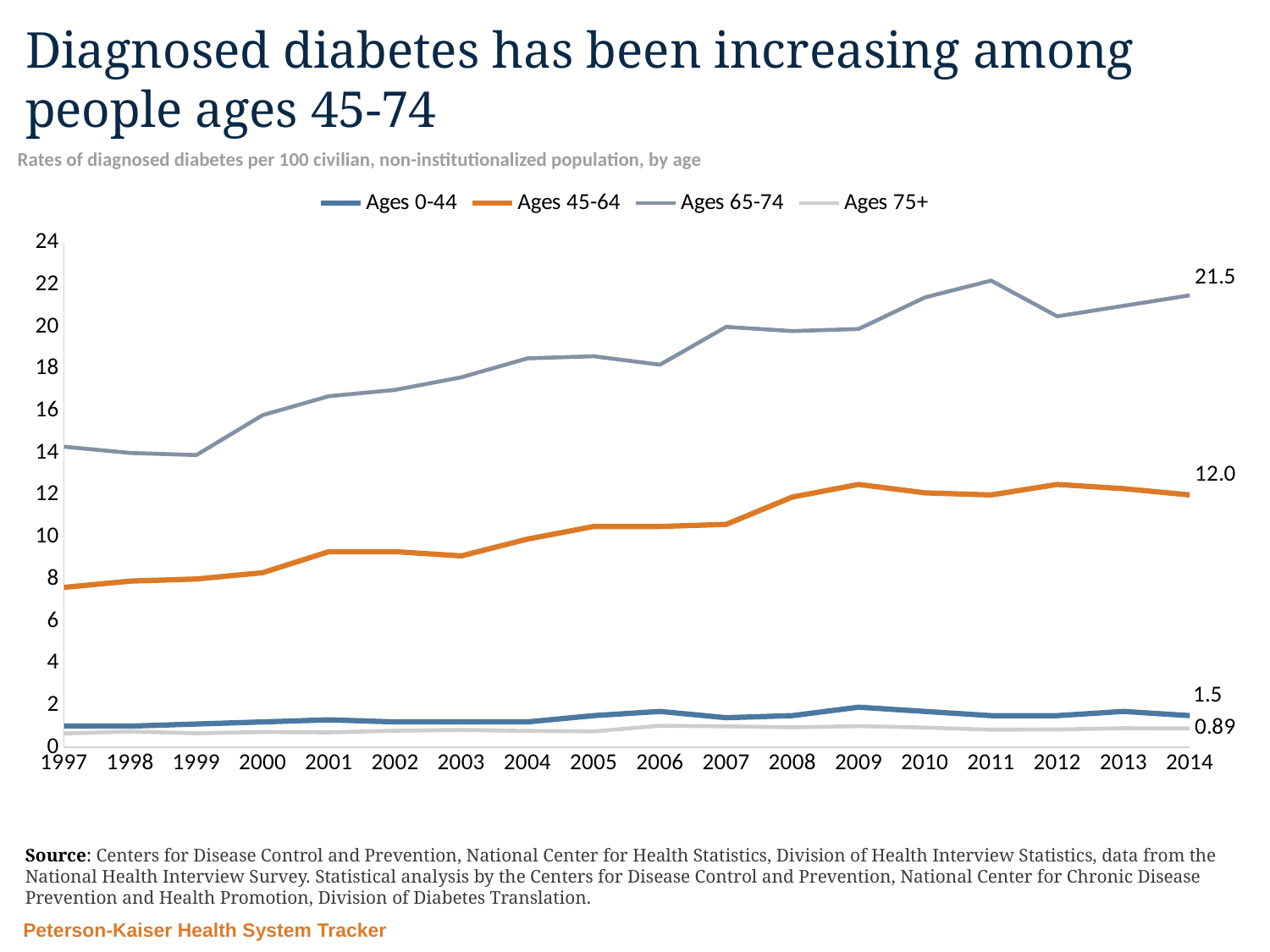
Which age group has the highest rate of diagnosed diabetes in 2014? Ages 65-74 What is the value for Ages 65-74 in 2014? 21.5 Which age group has the lowest rate of diagnosed diabetes in 2014? Ages 75+ What is the difference between the 2014 values for Ages 65-74 and Ages 45-64? 9.5 How many series does the legend list? 4 What is the value for Ages 0-44 in 2014? 1.5 How many years are shown on the x axis? 18 Is the value for Ages 65-74 in 1997 greater or less than 12? greater What is the value for Ages 45-64 in 2014? 12.0 In 2014, which is larger: the value for Ages 45-64 or the value for Ages 0-44? Ages 45-64 What is the value for Ages 75+ in 2014? 0.89 Is the value for Ages 45-64 in 1997 greater or less than 10? less